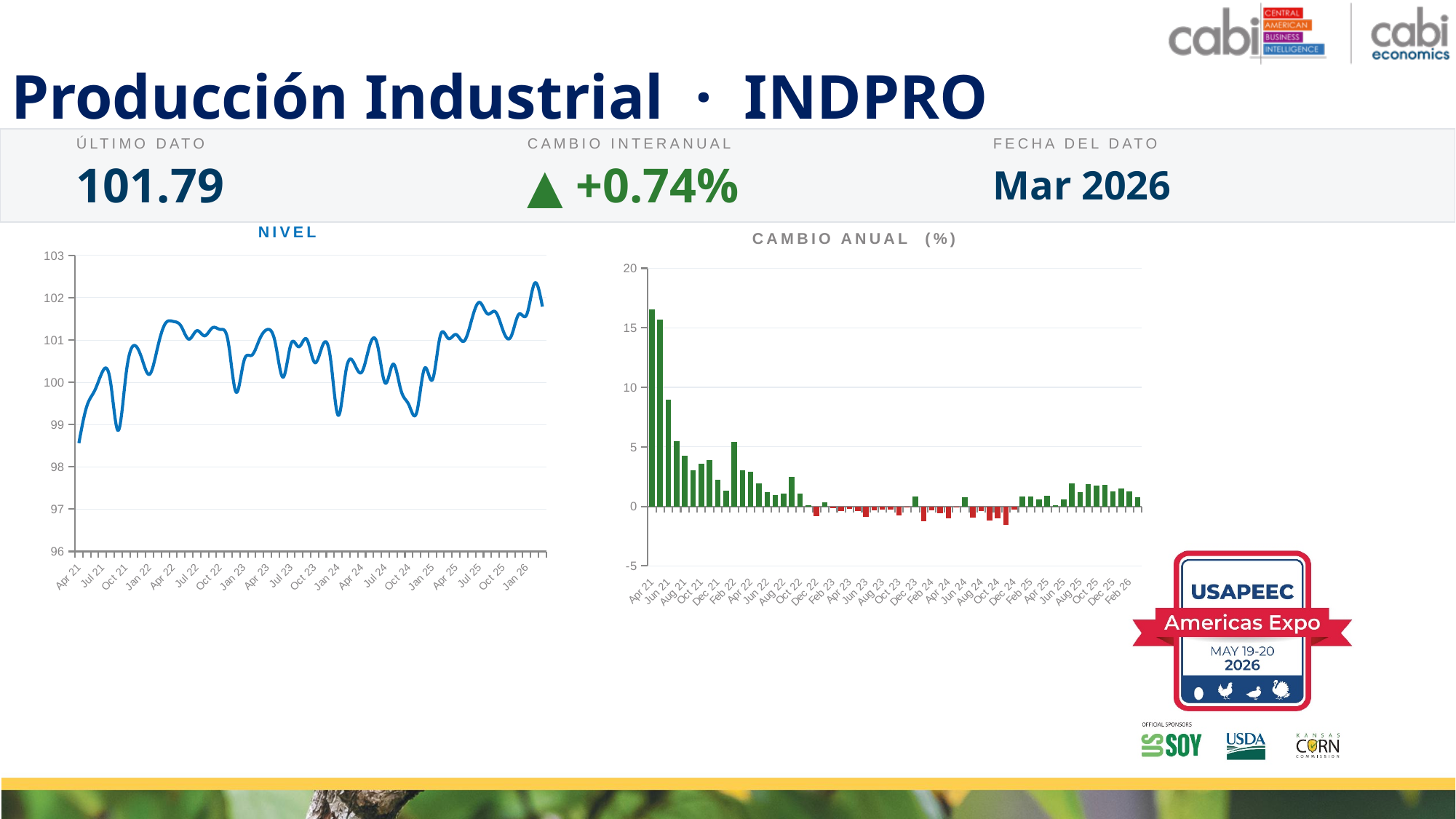
What kind of chart is the CAMBIO ANUAL (%) chart on the right? bar chart In the NIVEL chart, is the value for Jan 26 greater or less than 101? greater What is the title of the chart on the left of the slide? NIVEL In the CAMBIO ANUAL (%) chart, which is larger, the value for Apr 21 or the value for Feb 26? Apr 21 In the CAMBIO ANUAL (%) chart, is the value for Jun 21 greater or less than 10? less In the CAMBIO ANUAL (%) chart, which period has the highest bar? Apr 21 In the NIVEL chart, is the value for Oct 24 greater or less than 100? less In the CAMBIO ANUAL (%) chart, do the bars generally rise or fall from Apr 21 to Dec 22? fall What kind of chart is the NIVEL chart on the left? line chart